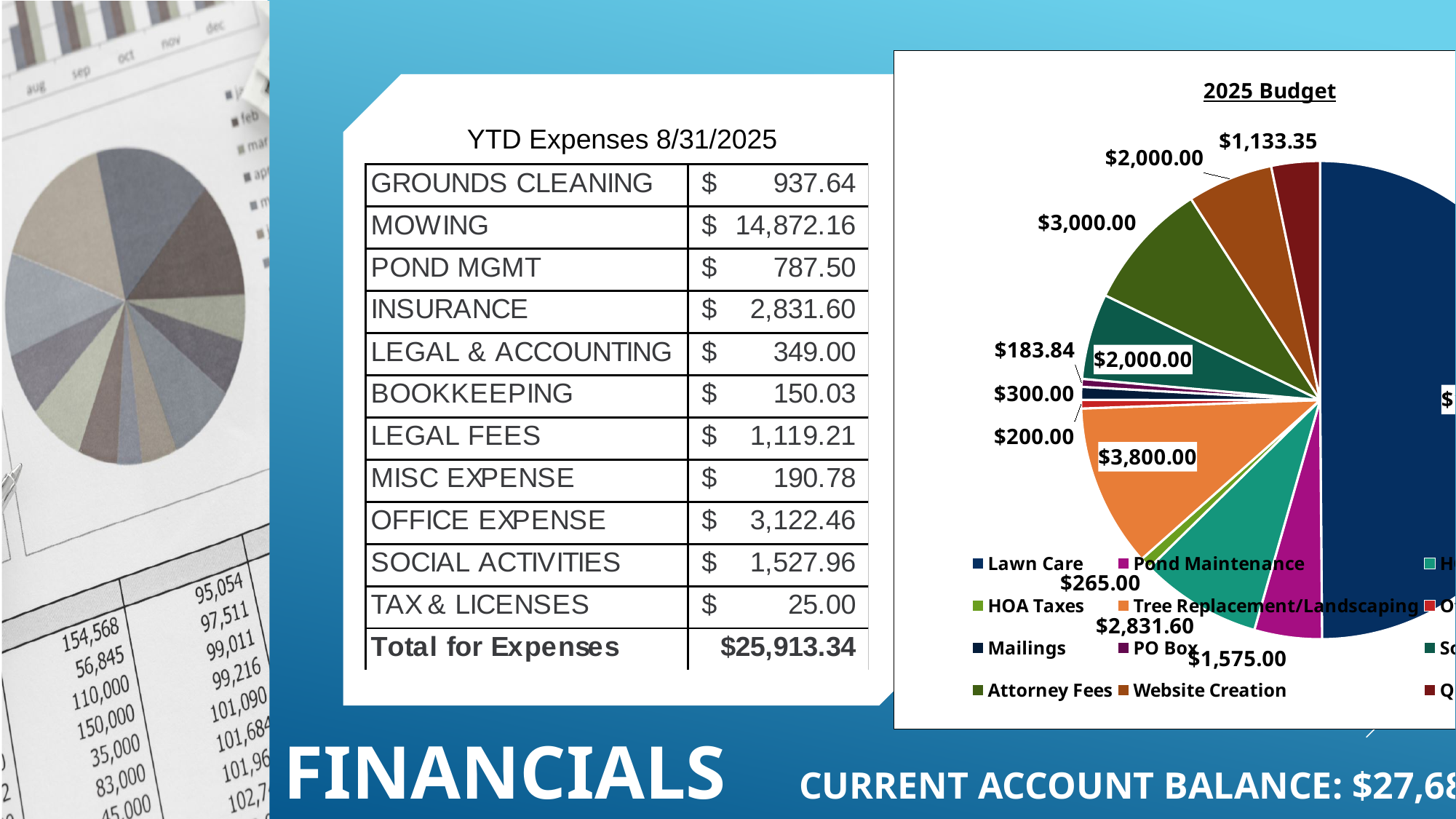
In the 2025 Budget pie chart, which is larger: Attorney Fees or Website Creation? Attorney Fees In the 2025 Budget pie chart, what is the value for HOA Taxes? $265.00 In the 2025 Budget pie chart, what colour is the Lawn Care slice? dark navy blue In the 2025 Budget pie chart, what is the difference between Tree Replacement/Landscaping and Attorney Fees? $800.00 In the 2025 Budget pie chart, what is the value for Website Creation? $2,000.00 In the 2025 Budget pie chart, which category has the largest slice? Lawn Care In the 2025 Budget pie chart, what is the value for Tree Replacement/Landscaping? $3,800.00 What kind of chart is shown on the slide? pie chart What is the title of the pie chart? 2025 Budget In the 2025 Budget pie chart, which is larger: Tree Replacement/Landscaping or Attorney Fees? Tree Replacement/Landscaping In the 2025 Budget pie chart, what is the value for Pond Maintenance? $1,575.00 In the 2025 Budget pie chart, what is the value for Attorney Fees? $3,000.00